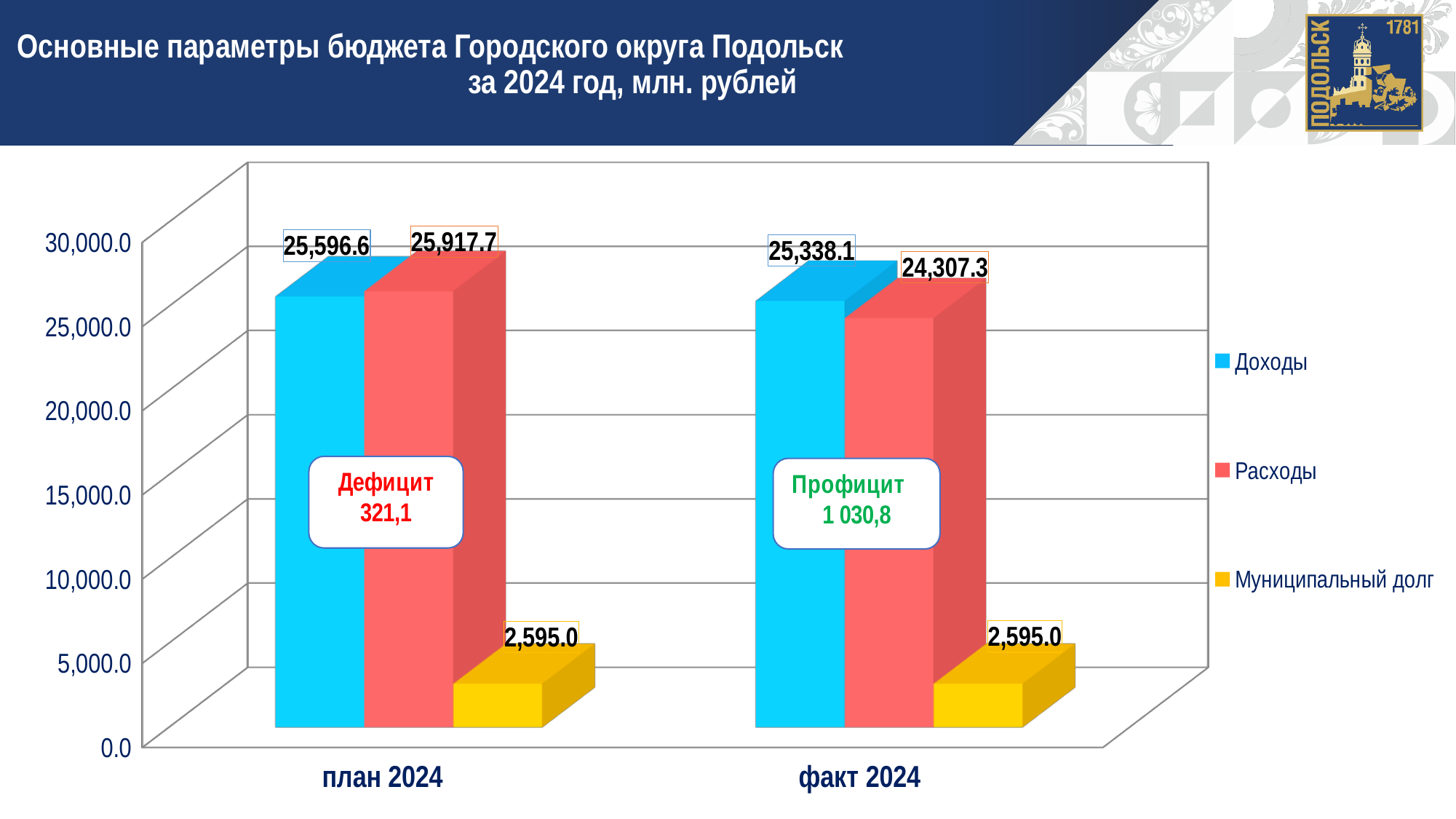
How many series does the legend list? 3 Is the value of Муниципальный долг for план 2024 greater or less than 5,000.0? less What is the value of Доходы for план 2024? 25,596.6 What is the value of Расходы for факт 2024? 24,307.3 Which is larger for факт 2024: Доходы or Расходы? Доходы What is the difference between Доходы and Расходы for факт 2024? 1,030.8 What is the difference between Расходы and Доходы for план 2024? 321.1 How many categories are shown on the x axis? 2 Which series has the lowest value in the факт 2024 group? Муниципальный долг Which series has the highest value in the план 2024 group? Расходы What kind of chart is shown on the slide? bar chart What is the value of Муниципальный долг for факт 2024? 2,595.0